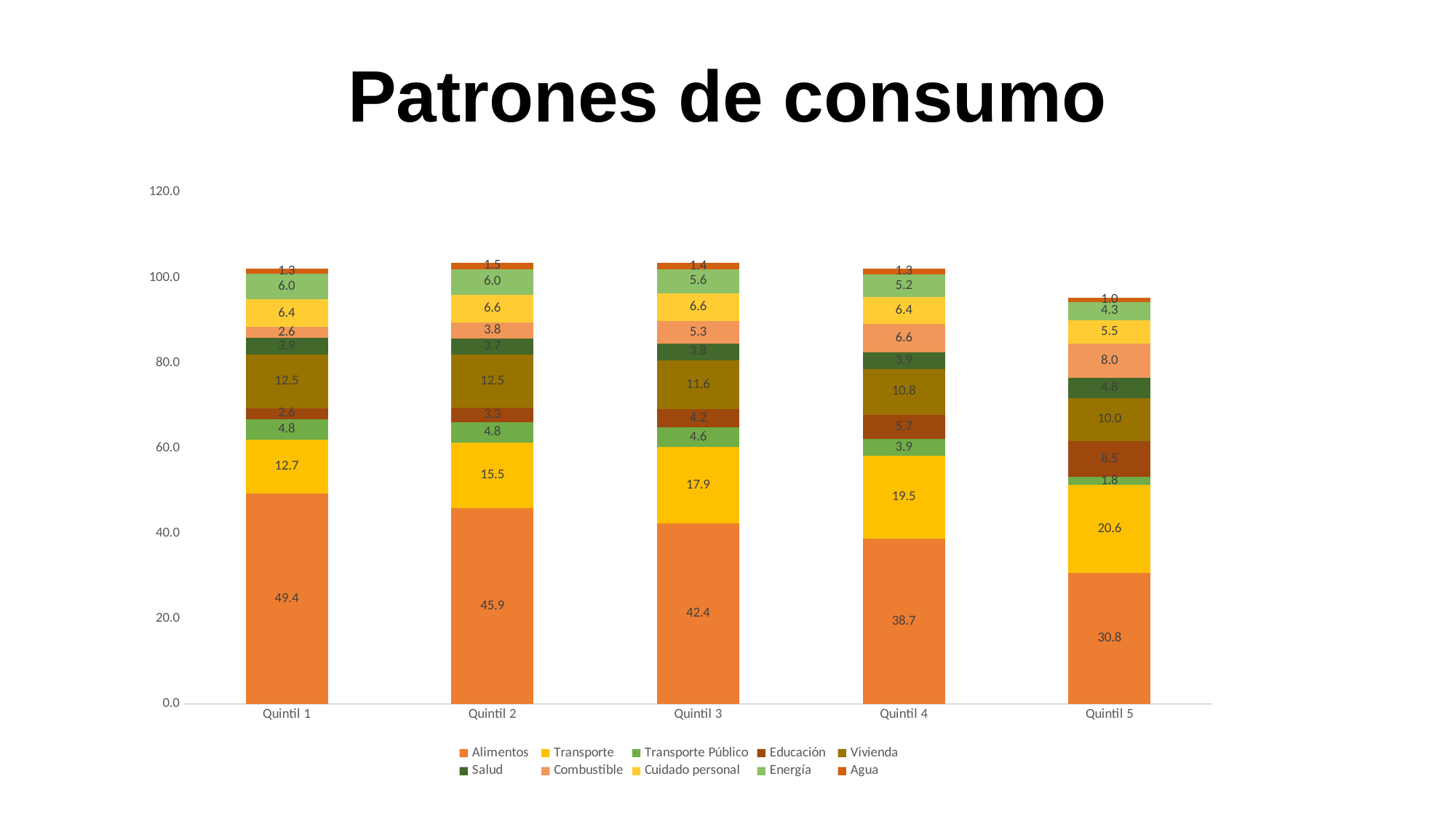
How many series does the legend list? 10 What kind of chart is shown on the slide? Stacked bar chart What is the Transporte value for Quintil 5? 20.6 What is the difference between the Transporte value for Quintil 5 and for Quintil 1? 7.9 Does the Alimentos value rise or fall from Quintil 1 to Quintil 5? Fall What is the Educación value for Quintil 4? 5.7 What is the Alimentos value for Quintil 1? 49.4 What is the Vivienda value for Quintil 3? 11.6 Which quintile has the lowest Transporte Público value? Quintil 5 How many quintiles are shown on the x axis? 5 Which quintile has the highest Alimentos value? Quintil 1 Which is larger: the Combustible value for Quintil 5 or for Quintil 2? Quintil 5